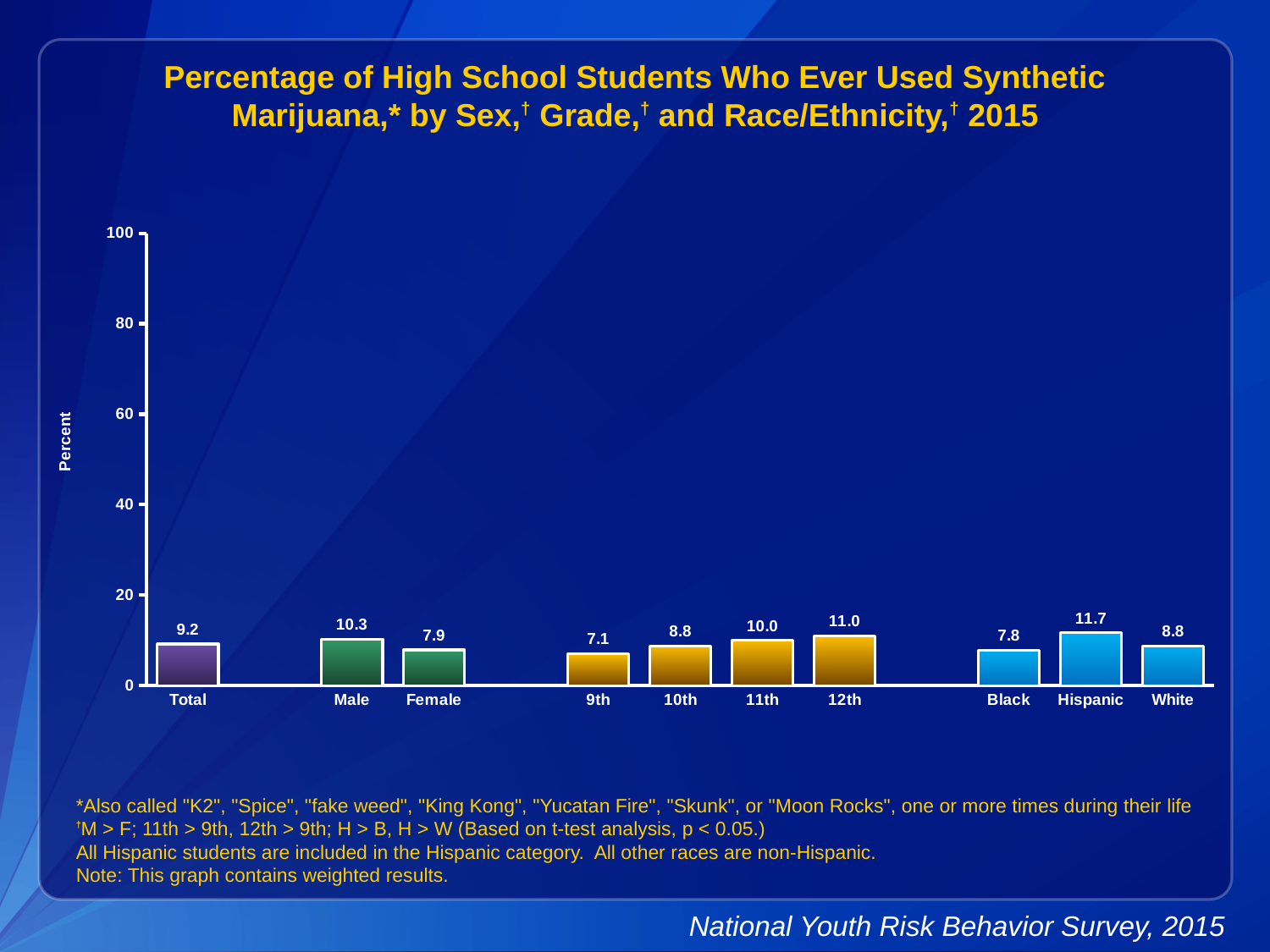
What is the label on the y axis? Percent Do the values rise or fall from 9th grade to 12th grade? rise What is the value for 9th grade students? 7.1 Which category has the lowest value? 9th Is the value for 12th grade greater or less than 20? less What is the difference between the values for Male and Female? 2.4 How many categories are shown on the x axis? 10 What is the value for Hispanic students? 11.7 Which is larger, the value for Black or the value for White? White What is the value for Total? 9.2 Which category has the highest value? Hispanic What kind of chart is this? bar chart